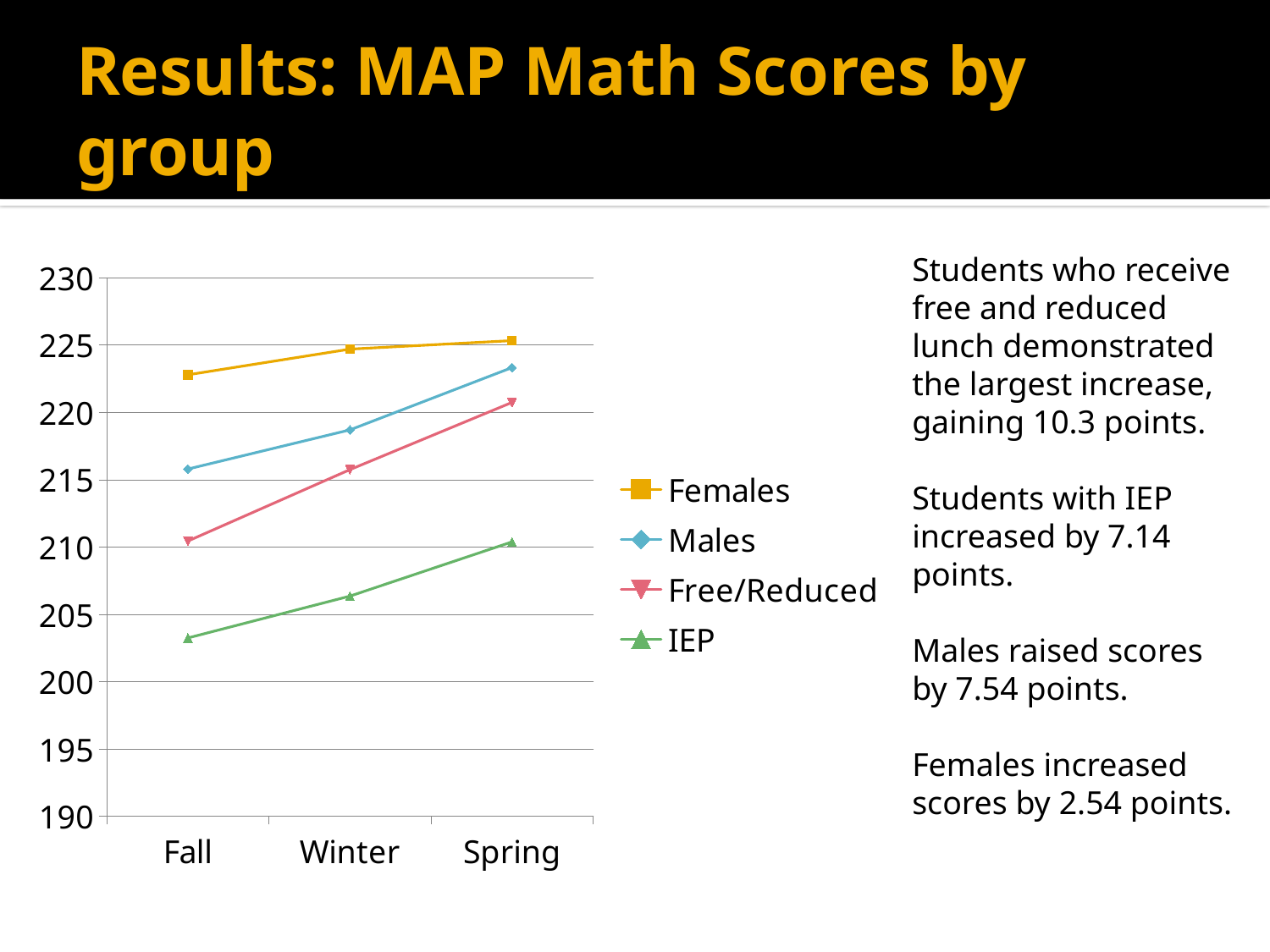
Do the IEP values rise or fall from Fall to Spring? rise How many points are on the x axis of the chart? 3 Is the value for IEP at Fall greater or less than 205? less Which series has the lowest value at Fall? IEP At Winter, which is larger: the value for Males or the value for Free/Reduced? Males What is the title of the slide containing the chart? Results: MAP Math Scores by group Is the value for Females at Fall greater or less than 220? greater How many series does the legend list? 4 Which series has the highest value at Spring? Females Is the value for Males at Spring greater or less than 220? greater What kind of chart is shown on the slide? line chart